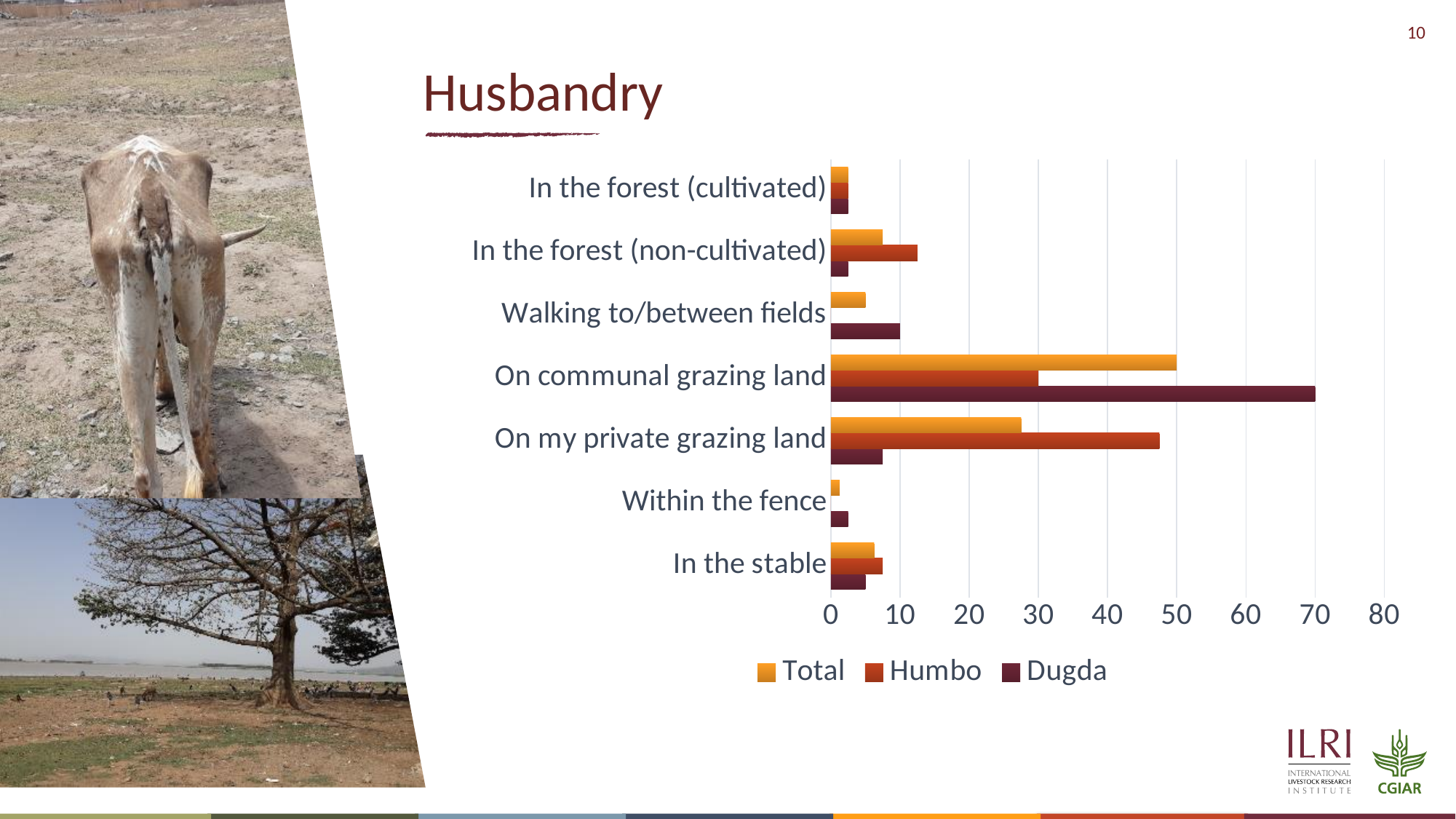
What kind of chart is shown on the slide? bar chart For On communal grazing land, which is larger: the Dugda value or the Humbo value? Dugda Which category has the highest Dugda value? On communal grazing land Is the Humbo value for On my private grazing land greater or less than 40? greater How many series does the legend list? 3 How many categories are shown on the chart? 7 Which category has the highest Total value? On communal grazing land For On my private grazing land, which is larger: the Humbo value or the Total value? Humbo What are the three series named in the legend? Total, Humbo, Dugda Is the Humbo value for On communal grazing land greater or less than 40? less Which category has the highest Humbo value? On my private grazing land Is the Dugda value for On communal grazing land greater or less than 60? greater